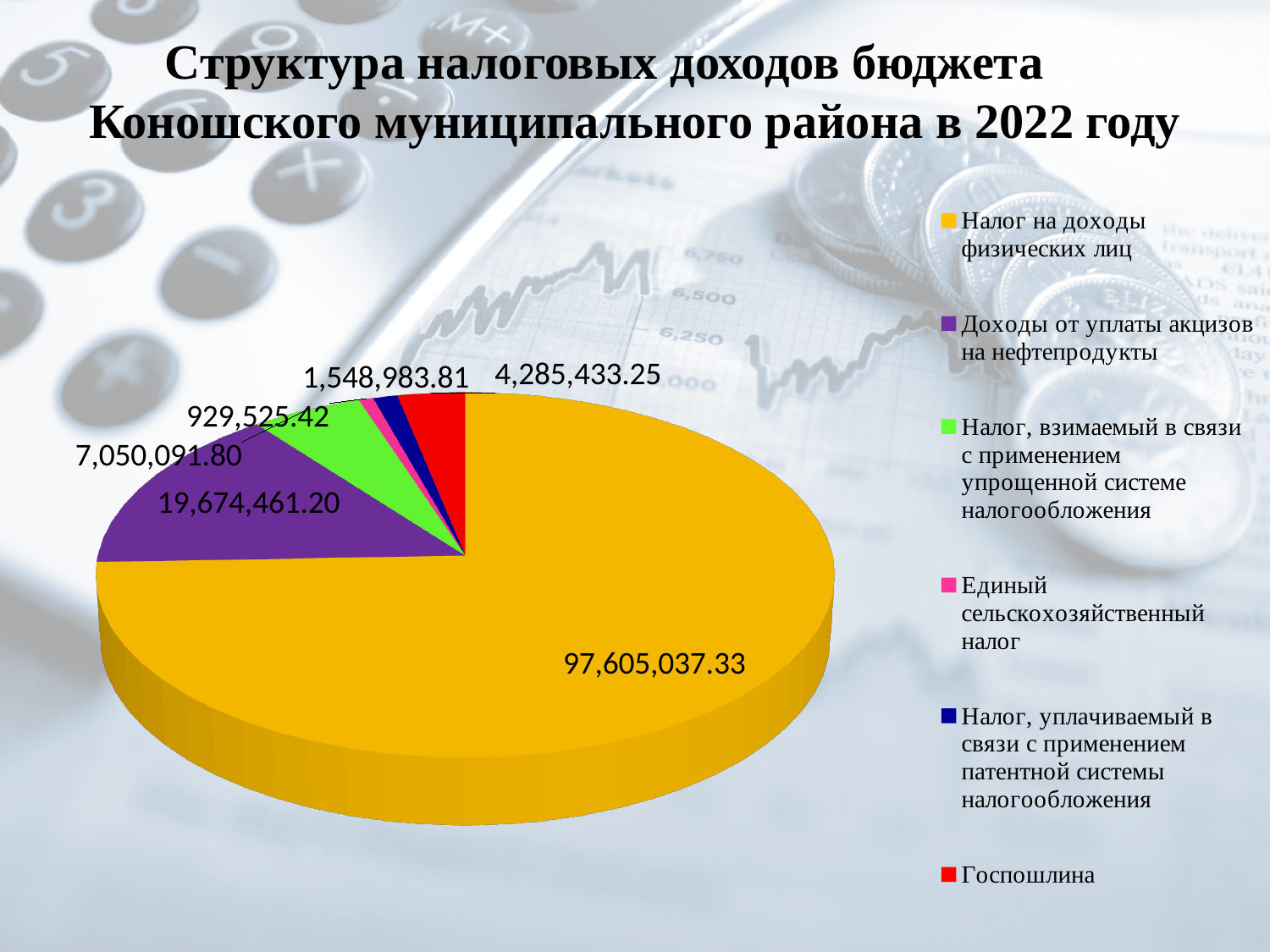
What is the value for Доходы от уплаты акцизов на нефтепродукты? 19,674,461.20 What colour is the slice for Доходы от уплаты акцизов на нефтепродукты? Purple Which category has the largest slice of the pie? Налог на доходы физических лиц How many slices does the pie chart have? 6 What is the value for Госпошлина? 4,285,433.25 Which is larger: Госпошлина or Налог, уплачиваемый в связи с применением патентной системы налогообложения? Госпошлина What kind of chart is shown on the slide? Pie chart What is the value for Единый сельскохозяйственный налог? 929,525.42 What is the value for Налог на доходы физических лиц? 97,605,037.33 What is the difference between Налог на доходы физических лиц and Доходы от уплаты акцизов на нефтепродукты? 77,930,576.13 How many entries does the legend list? 6 Which category has the smallest slice of the pie? Единый сельскохозяйственный налог